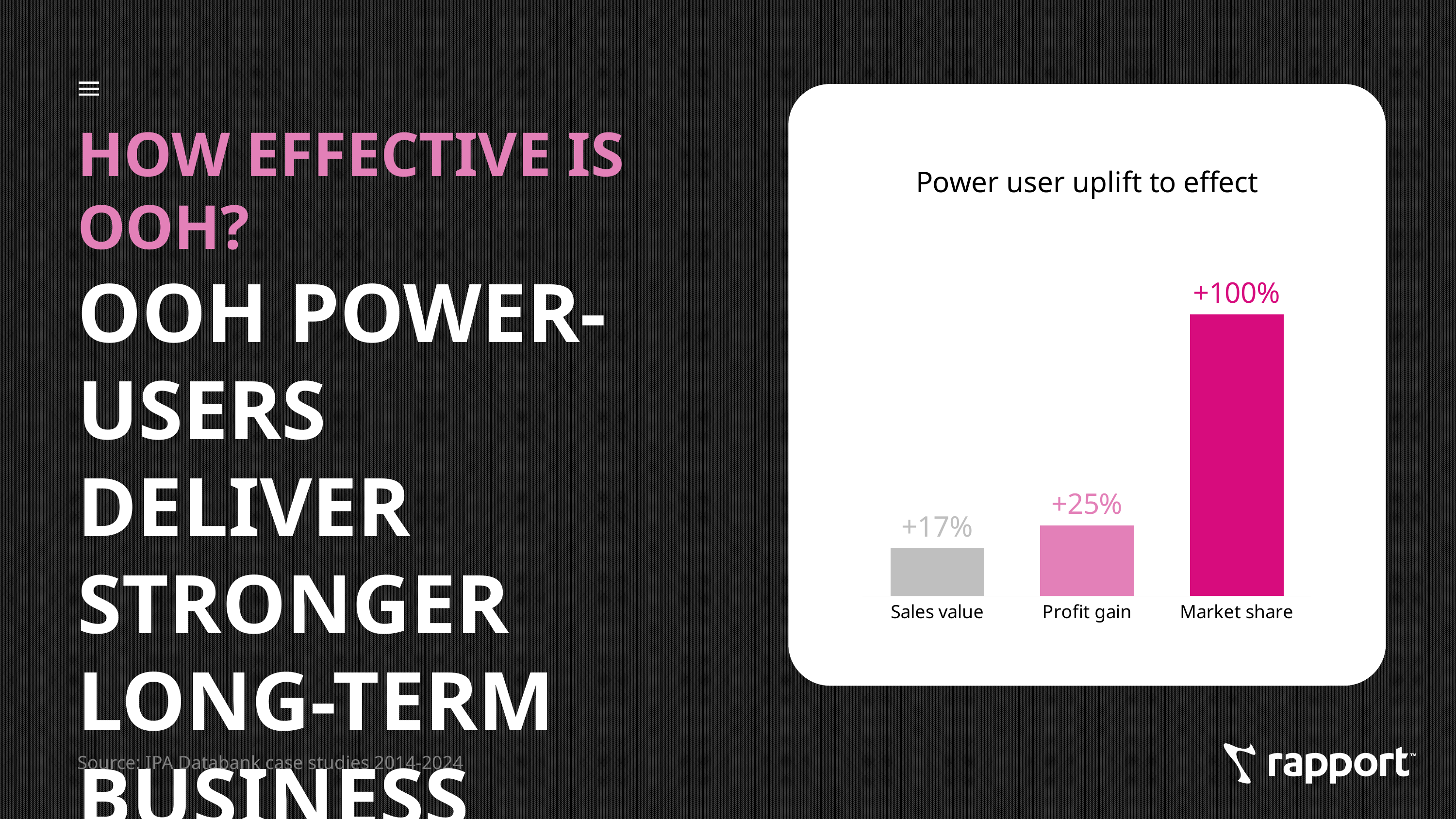
What is the difference between the values for Market share and Profit gain? 75% Which is larger, the value for Profit gain or the value for Sales value? Profit gain What kind of chart is shown on the slide? Bar chart What is the title of the chart? Power user uplift to effect Which category has the highest value in the chart? Market share What is the value for Profit gain in the chart? +25% What is the value for Sales value in the chart? +17% Which category has the lowest value in the chart? Sales value Do the values rise or fall from left to right across the categories? Rise What is the value for Market share in the chart? +100% What is the difference between the values for Profit gain and Sales value? 8% How many categories are shown in the chart? 3